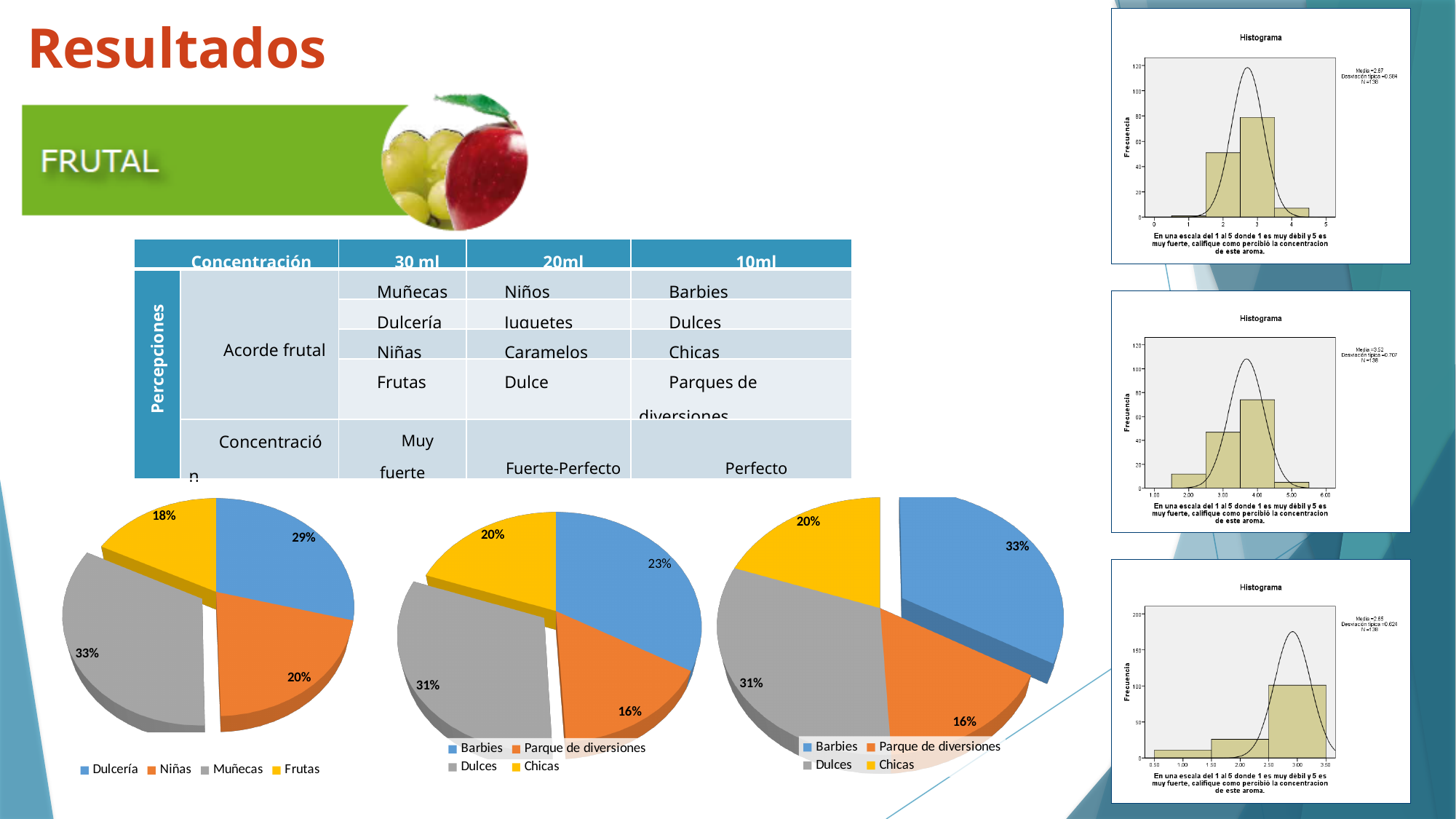
In the left pie chart, what percentage is shown for Muñecas? 33% In the right pie chart, which category has the smallest share? Parque de diversiones How many categories does the legend of the right pie chart list? 4 In the left pie chart, which category has the smallest share? Frutas In the right pie chart, what percentage is shown for Barbies? 33% In the left pie chart, what is the difference in percentage points between Dulcería and Niñas? 9 In the middle pie chart, what percentage is shown for Barbies? 23% In the left pie chart, what percentage is shown for Frutas? 18% In the middle pie chart, which is larger, Chicas or Parque de diversiones? Chicas In the left pie chart, which category has the largest share? Muñecas What kind of chart are the three charts at the bottom of the slide? Pie charts